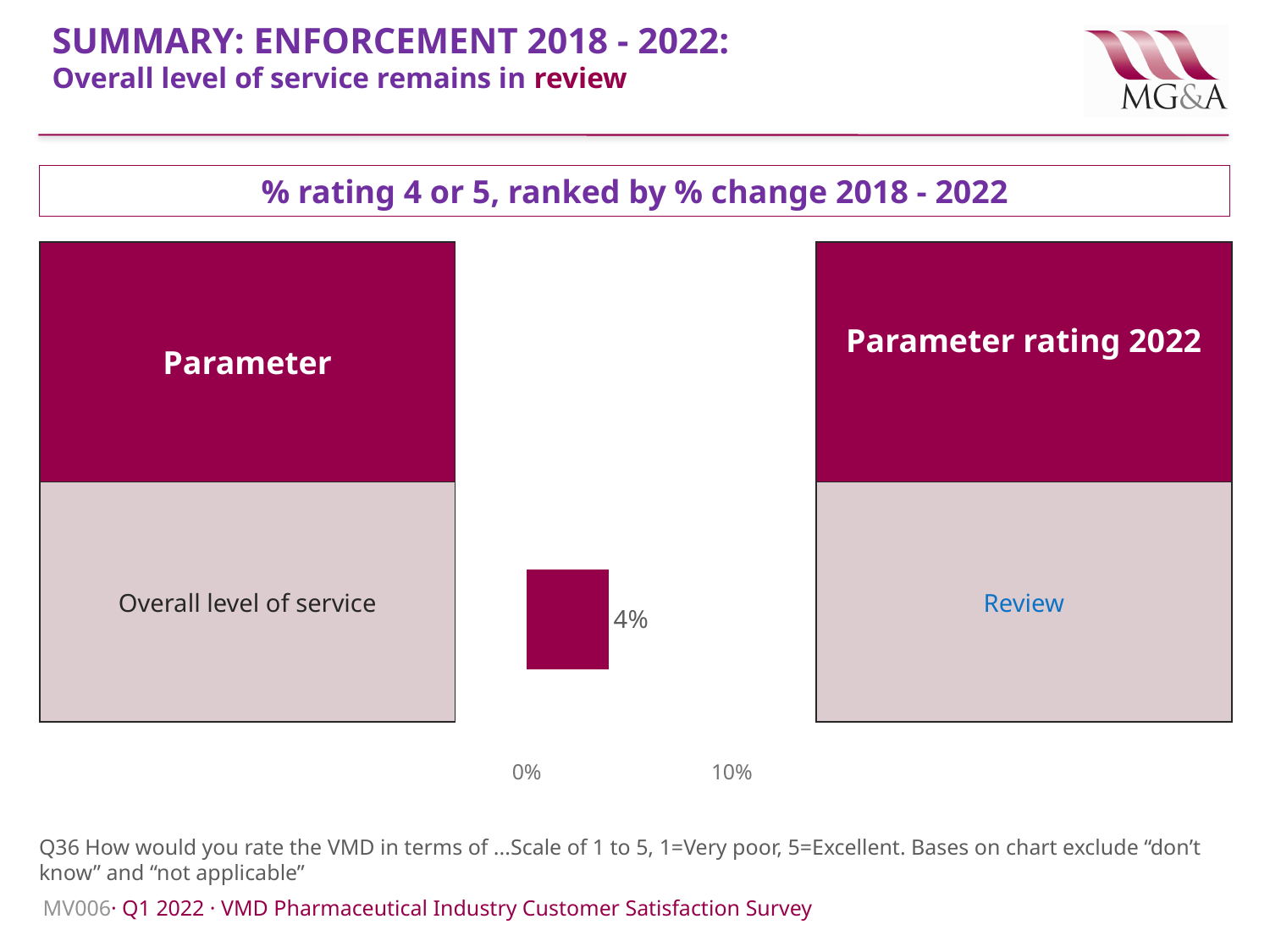
Is the value for Overall level of service greater or less than 0%? greater What kind of chart is shown on the slide? bar chart What is the % change 2018 - 2022 shown for Overall level of service? 4% What is the title of the chart? % rating 4 or 5, ranked by % change 2018 - 2022 What is the Parameter rating 2022 given for Overall level of service? Review Is the value for Overall level of service greater or less than 10%? less How many categories are plotted in the chart? 1 Which category is plotted in the chart? Overall level of service What is the highest value shown on the chart's x axis? 10%